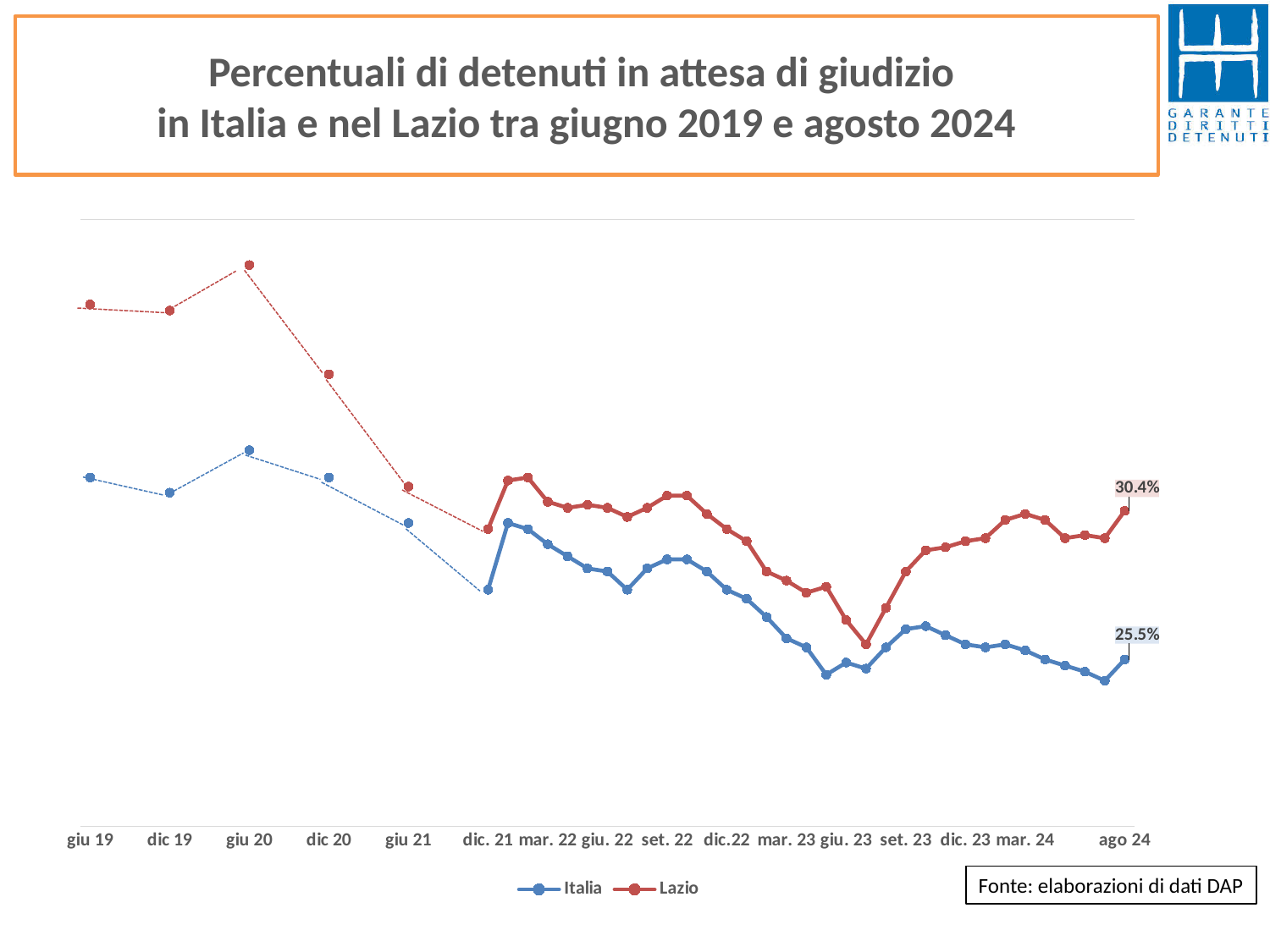
What is the value for Lazio at ago 24? 30.4% What is the source cited for the chart data? Fonte: elaborazioni di dati DAP What is the difference between the Lazio and Italia values at ago 24? 4.9 percentage points At which x-axis label does the Lazio series reach its highest point? giu 20 What kind of chart is shown on the slide? Line chart How many series does the legend list? 2 Does the Lazio line rise or fall between giu 20 and giu 21? Falls Which series is plotted in red? Lazio What is the value for Italia at ago 24? 25.5% At ago 24, which series has the higher value, Italia or Lazio? Lazio How many labels are shown on the x axis? 16